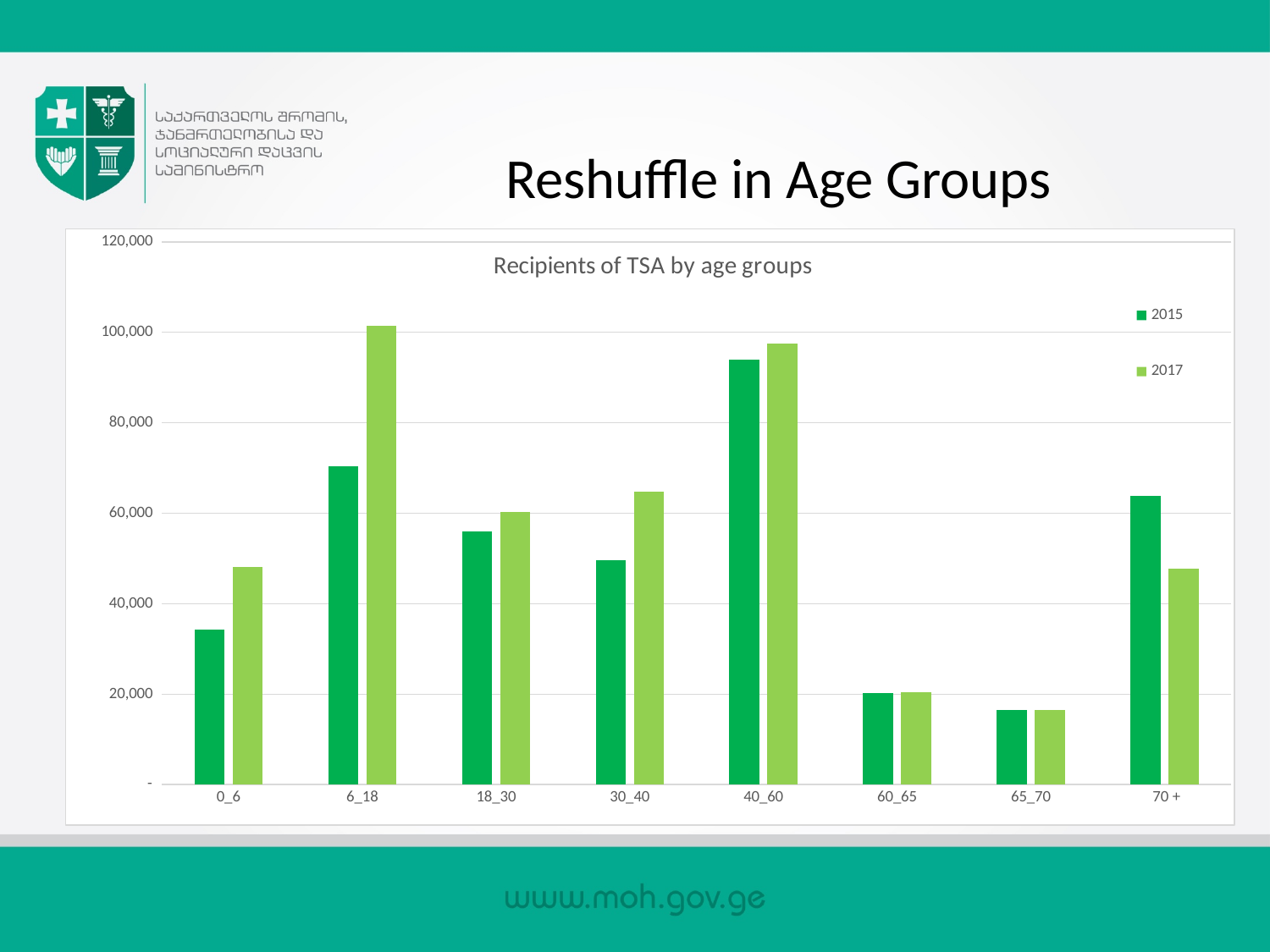
Which age group has the lowest value for 2015? 65_70 Which age group has the highest value for 2015? 40_60 Which years are listed in the chart legend? 2015 and 2017 Which age group has the highest value for 2017? 6_18 Is the 2015 value for the 0_6 age group greater or less than 40,000? less For the 70 + age group, which year has the larger value, 2015 or 2017? 2015 How many age groups are shown on the x axis? 8 What is the title of the chart? Recipients of TSA by age groups How many series does the legend list? 2 Is the 2017 value for the 40_60 age group greater or less than 80,000? greater What kind of chart is shown on the slide? bar chart For the 6_18 age group, which year has the larger value, 2015 or 2017? 2017